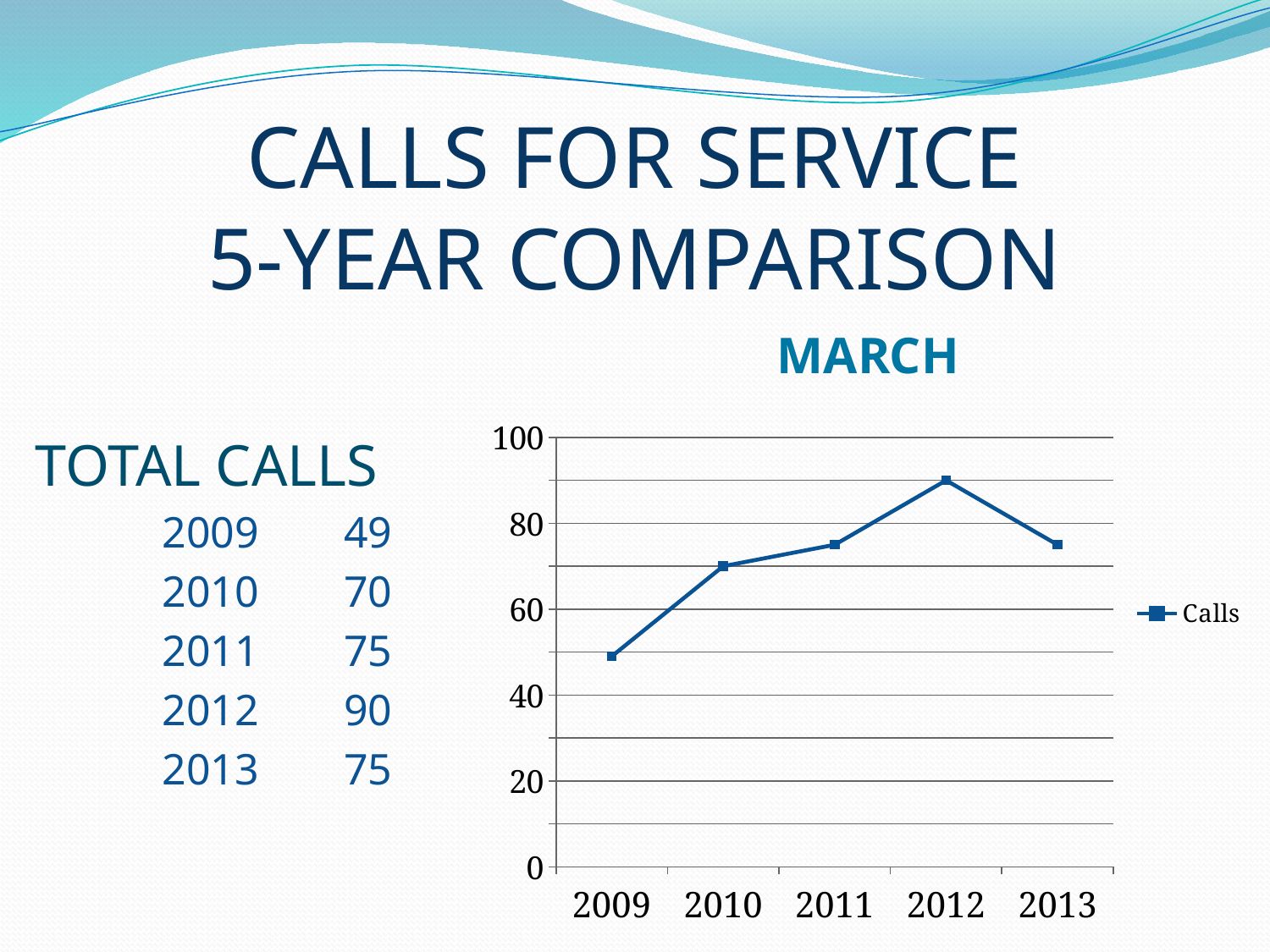
What type of chart is shown on the slide? Line chart What is the difference in calls between 2012 and 2013? 15 Which year has more calls, 2010 or 2011? 2011 How many series does the legend list? 1 Do the calls rise or fall from 2009 to 2012? Rise Which year has the highest number of calls? 2012 What is the number of calls for 2012? 90 What is the number of calls for 2009? 49 Which year has the lowest number of calls? 2009 How many years are plotted on the x axis of the chart? 5 What is the chart's title? MARCH What is the number of calls for 2010? 70